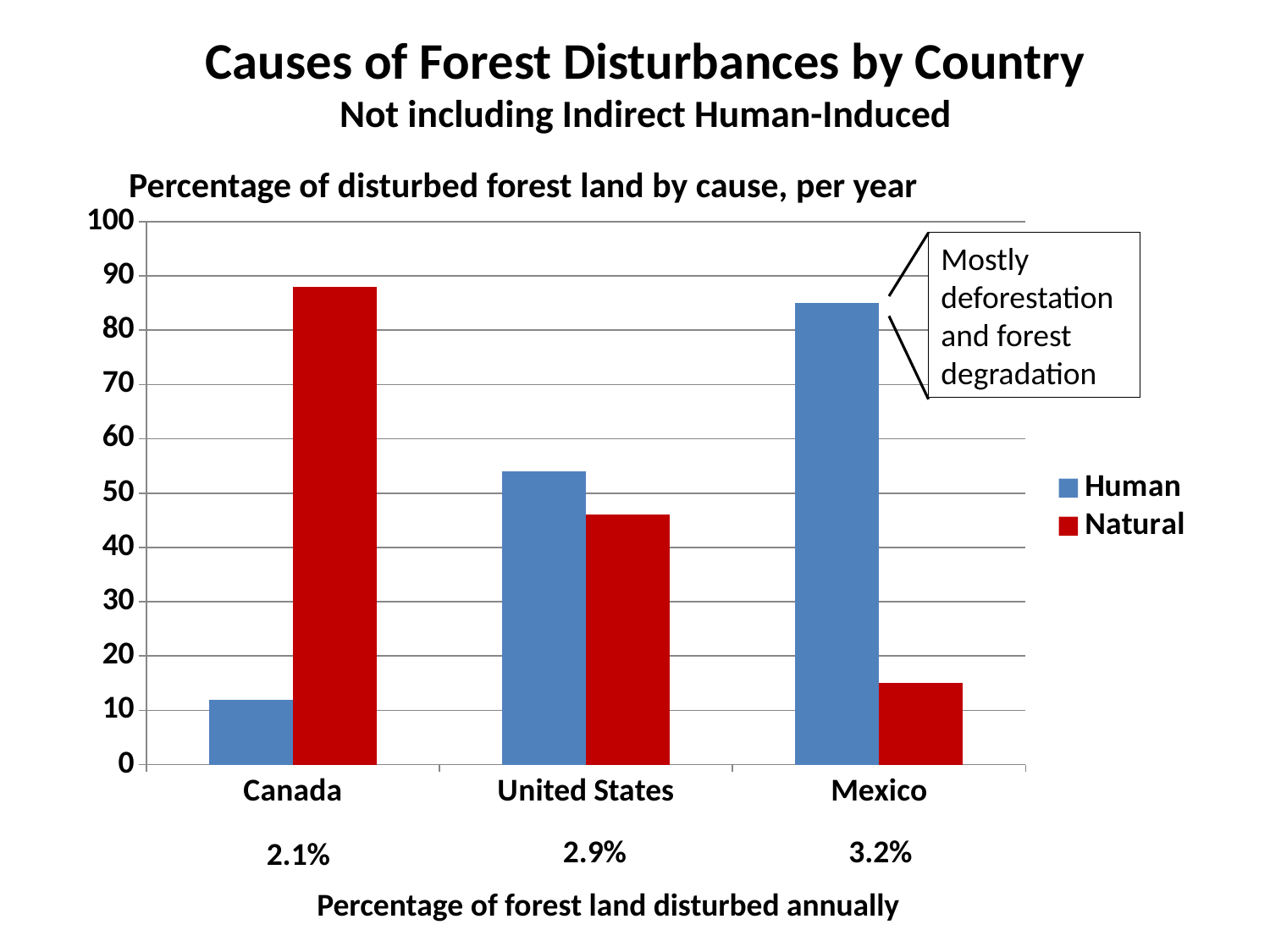
Which country has the lowest Human bar? Canada Is the Natural value for Canada greater or less than 80? greater For the United States, which is larger, the Human value or the Natural value? Human What are the two entries in the chart's legend? Human and Natural How many countries are shown on the x axis of the chart? 3 Which country has the highest Natural bar? Canada For Canada, which is larger, the Human value or the Natural value? Natural How many series does the chart's legend list? 2 Is the Natural value for Mexico greater or less than 20? less Which country has the highest Human bar? Mexico What kind of chart is shown on the slide? bar chart Which country has the lowest Natural bar? Mexico